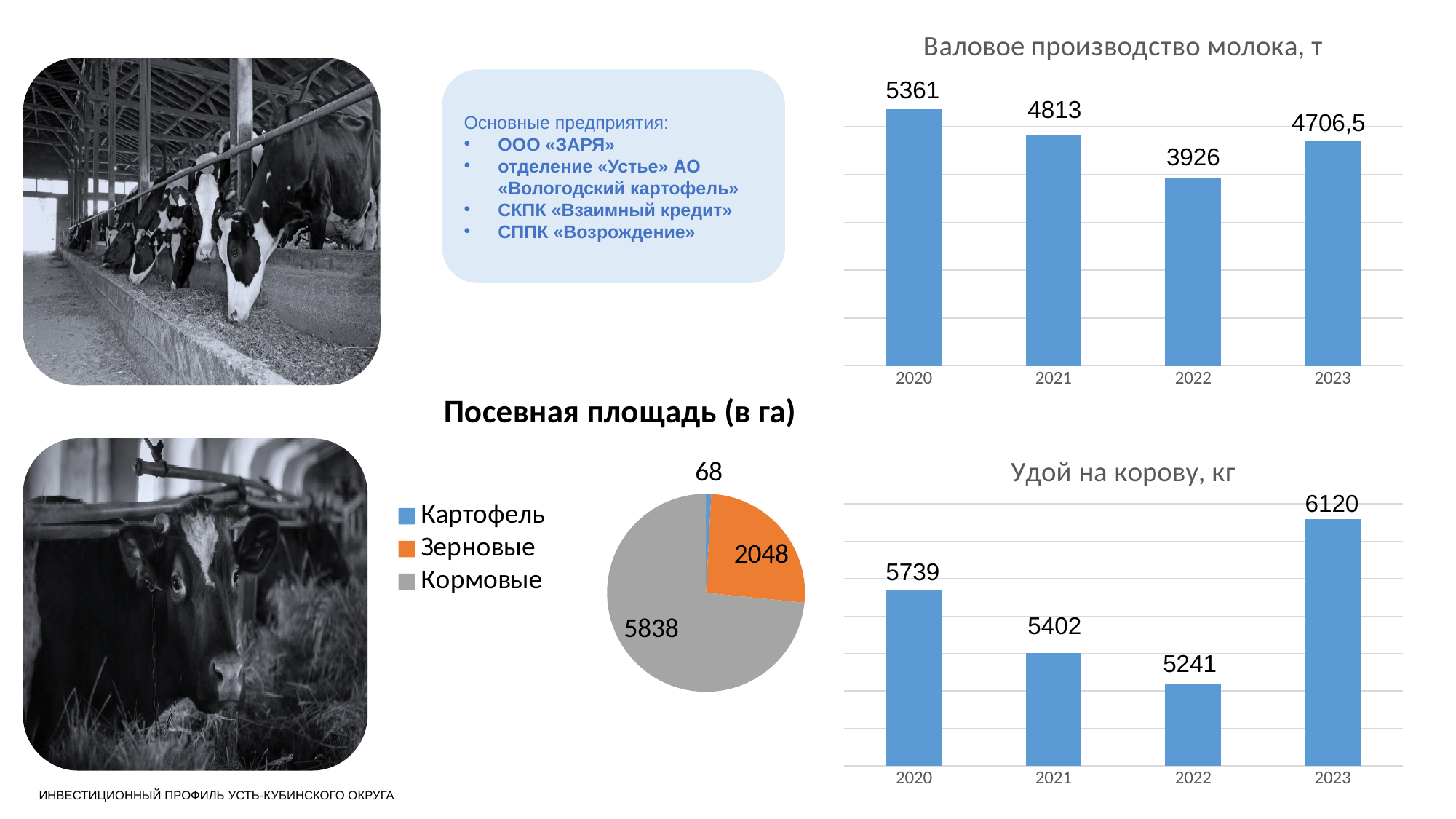
In the chart 'Валовое производство молока, т', what is the difference between the values for 2020 and 2021? 548 How many categories does the legend of the pie chart 'Посевная площадь (в га)' list? 3 In the chart 'Валовое производство молока, т', which year has the lowest value? 2022 How many years are shown in the chart 'Удой на корову, кг'? 4 What kind of chart is 'Посевная площадь (в га)'? pie chart In the chart 'Удой на корову, кг', which year has the highest value? 2023 In the chart 'Валовое производство молока, т', what is the value for 2023? 4706,5 In the chart 'Удой на корову, кг', what is the value for 2022? 5241 In the chart 'Валовое производство молока, т', what is the value for 2020? 5361 In the chart 'Удой на корову, кг', which is larger: the value for 2020 or the value for 2021? 2020 In the chart 'Удой на корову, кг', what is the difference between the values for 2023 and 2022? 879 In the pie chart 'Посевная площадь (в га)', what is the value for Зерновые? 2048